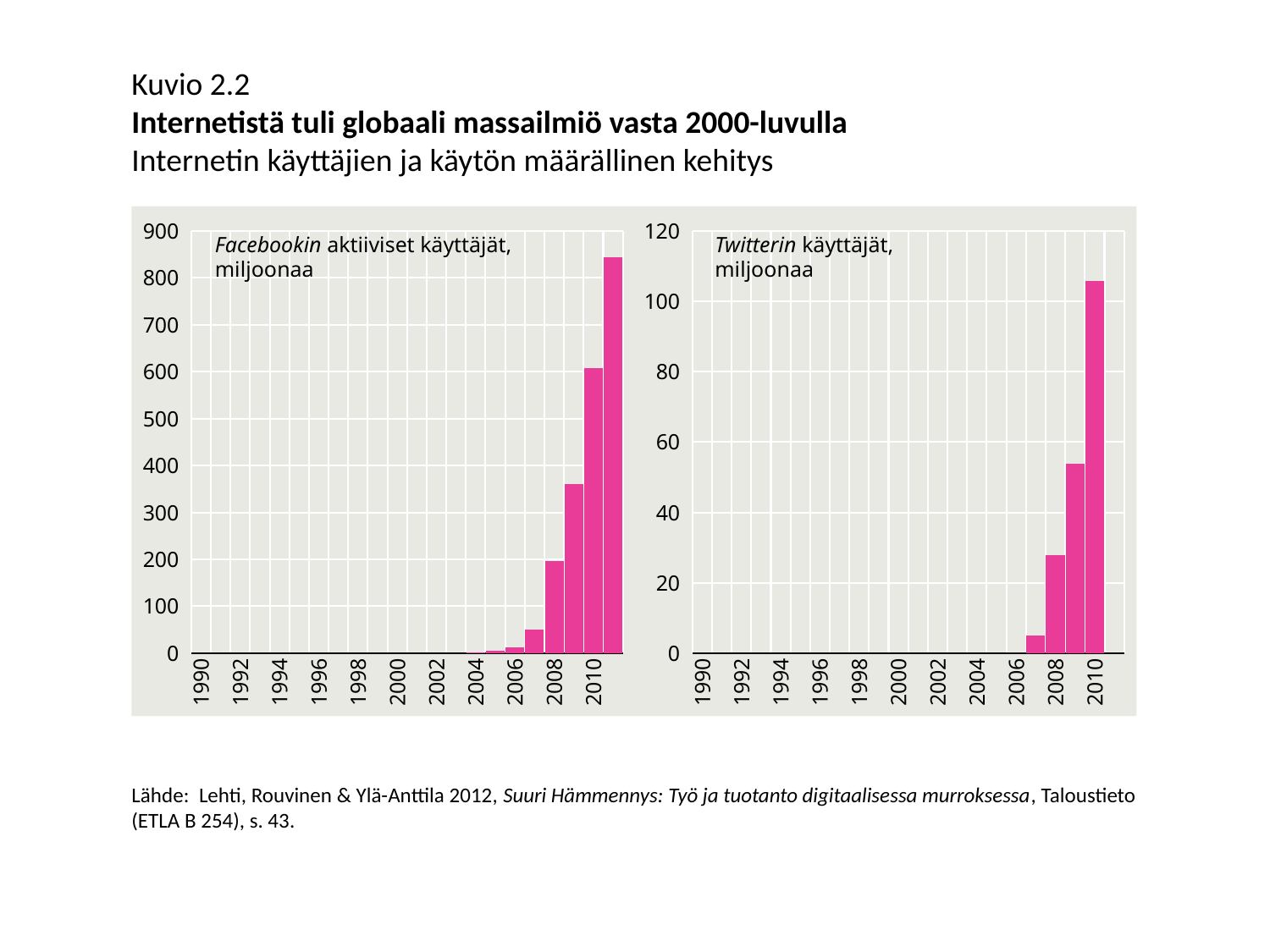
What unit is given for the values in the Twitterin käyttäjät chart? miljoonaa In the Twitterin käyttäjät chart, which is larger, the value for 2008 or the value for 2010? 2010 In the Facebookin aktiiviset käyttäjät chart, is the value for 2008 greater or less than 100? greater In the Facebookin aktiiviset käyttäjät chart, which is larger, the value for 2008 or the value for 2010? 2010 What kind of chart is the Twitterin käyttäjät chart? bar chart In the Facebookin aktiiviset käyttäjät chart, do the values rise or fall from 2006 to 2010? rise What kind of chart is the Facebookin aktiiviset käyttäjät chart? bar chart In the Twitterin käyttäjät chart, which year has the highest value? 2010 In the Facebookin aktiiviset käyttäjät chart, is the value for 2010 greater or less than 500? greater In the Twitterin käyttäjät chart, is the value for 2010 greater or less than 100? greater In the Twitterin käyttäjät chart, do the values rise or fall from 2007 to 2010? rise